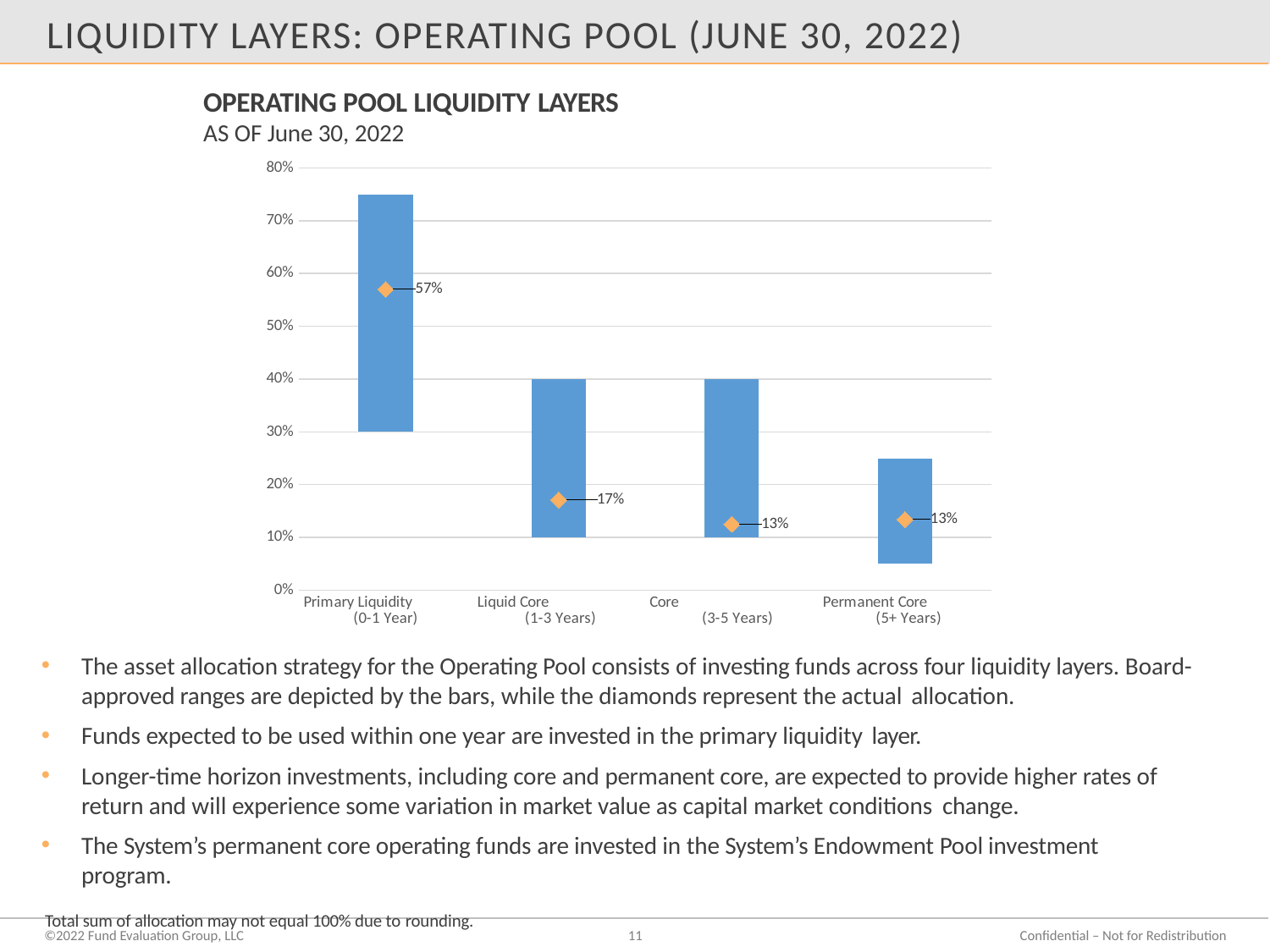
What kind of chart is used to show the liquidity layers? Bar chart with diamond markers How many liquidity layers are shown on the x axis? 4 Which has a larger actual allocation, Liquid Core (1-3 Years) or Permanent Core (5+ Years)? Liquid Core (1-3 Years) What is the actual allocation (diamond) for Primary Liquidity (0-1 Year)? 57% What is the difference between the actual allocation for Primary Liquidity (0-1 Year) and Liquid Core (1-3 Years)? 40 percentage points What is the actual allocation (diamond) for Permanent Core (5+ Years)? 13% Is the top of the Board-approved range bar for Primary Liquidity (0-1 Year) greater or less than 70%? greater Is the top of the Board-approved range bar for Permanent Core (5+ Years) greater or less than 30%? less What is the actual allocation (diamond) for Liquid Core (1-3 Years)? 17% Does the actual allocation rise or fall from Primary Liquidity (0-1 Year) to Core (3-5 Years)? falls What is the actual allocation (diamond) for Core (3-5 Years)? 13% Which liquidity layer has the highest actual allocation? Primary Liquidity (0-1 Year)